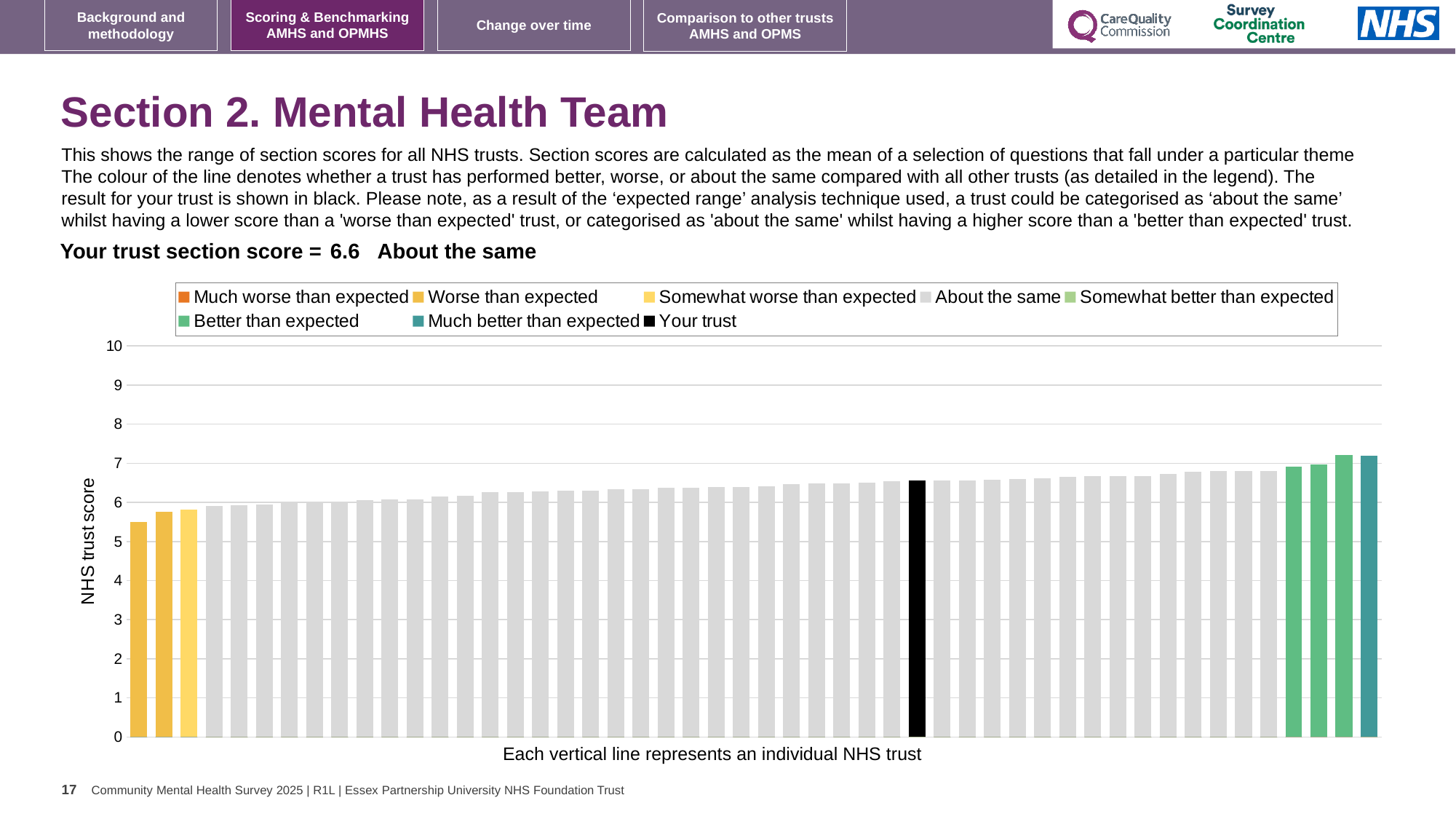
How many bars are coloured as 'Worse than expected' (yellow-orange) on the chart? 2 How many entries does the chart legend list? 8 What is the label on the y axis of the chart? NHS trust score What is the section score for your trust shown on the slide? 6.6 Is the value of the rightmost bar greater or less than 6? greater Is the value of the leftmost (lowest) bar greater or less than 6? less Is the value of the black 'Your trust' bar greater or less than 6? greater What kind of chart is shown on the slide? bar chart What colour is the bar representing your trust? black How many bars are coloured as 'Much better than expected' (teal) on the chart? 1 Do the bar values rise or fall from left to right along the x axis? rise Which category is your trust placed in for this section? About the same